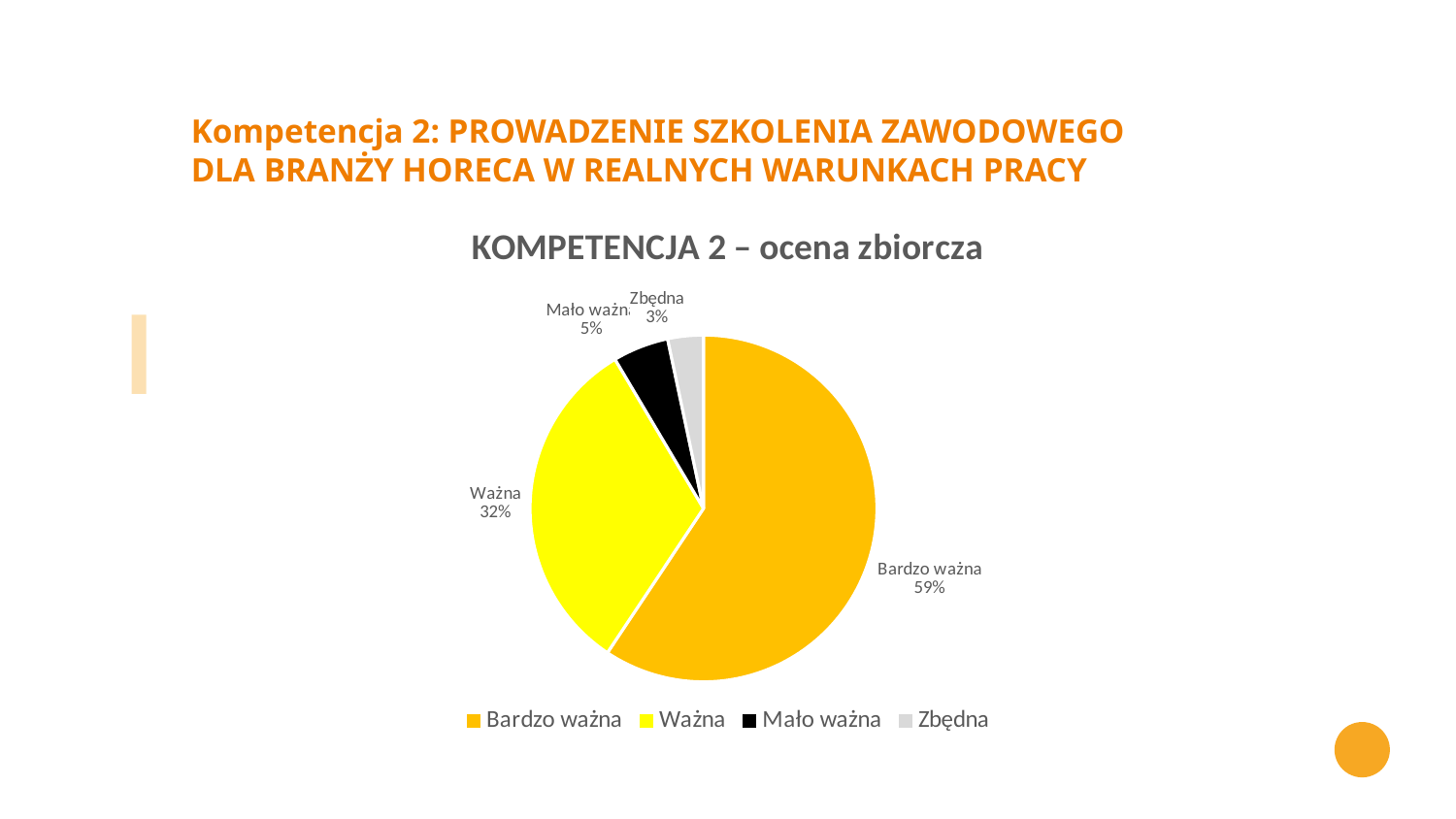
What colour is the "Ważna" slice? yellow How many categories does the legend list? 4 What is the difference in percentage points between "Bardzo ważna" and "Ważna"? 27 What share of the pie is labelled "Bardzo ważna"? 59% What is the chart's title? KOMPETENCJA 2 – ocena zbiorcza Which category has the smallest slice of the pie? Zbędna What share of the pie is labelled "Ważna"? 32% What kind of chart is shown on the slide? pie chart Which is larger, the share for "Mało ważna" or the share for "Zbędna"? Mało ważna What share of the pie is labelled "Zbędna"? 3% Which category has the largest slice of the pie? Bardzo ważna